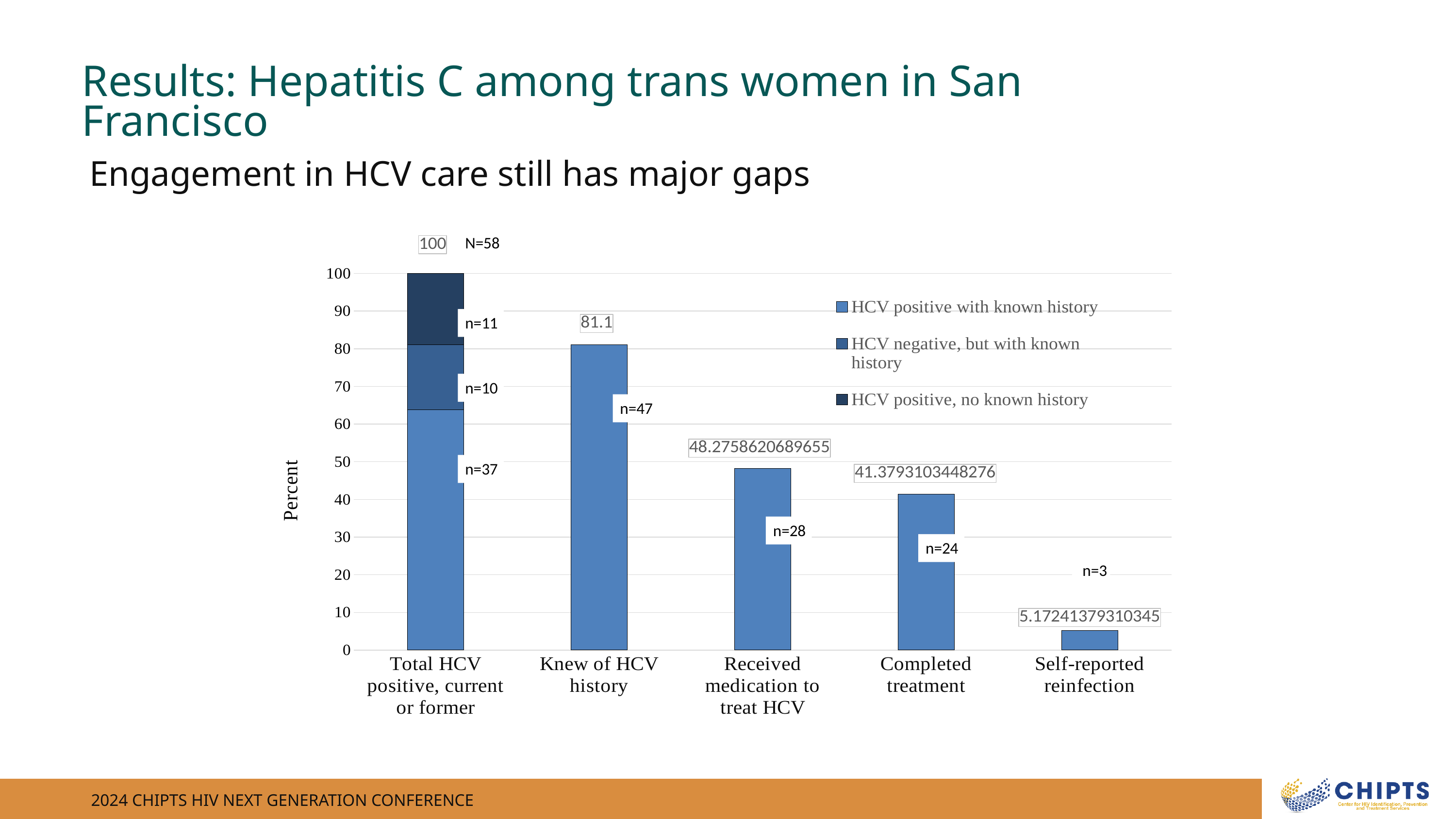
What is the percent value labelled for 'Completed treatment'? 41.3793103448276 How many series does the chart's legend list? 3 What is the percent value labelled for 'Received medication to treat HCV'? 48.2758620689655 What is the percent value labelled for 'Knew of HCV history'? 81.1 Which category has the lowest percent value? Self-reported reinfection What is the n count labelled for 'Completed treatment'? n=24 What is the total value labelled above the stacked bar for 'Total HCV positive, current or former'? 100 Which is larger, the percent for 'Knew of HCV history' or for 'Received medication to treat HCV'? Knew of HCV history How many categories are shown along the x axis of the chart? 5 What is the percent value labelled for 'Self-reported reinfection'? 5.17241379310345 What is the label of the y axis? Percent What kind of chart is shown on the slide? bar chart